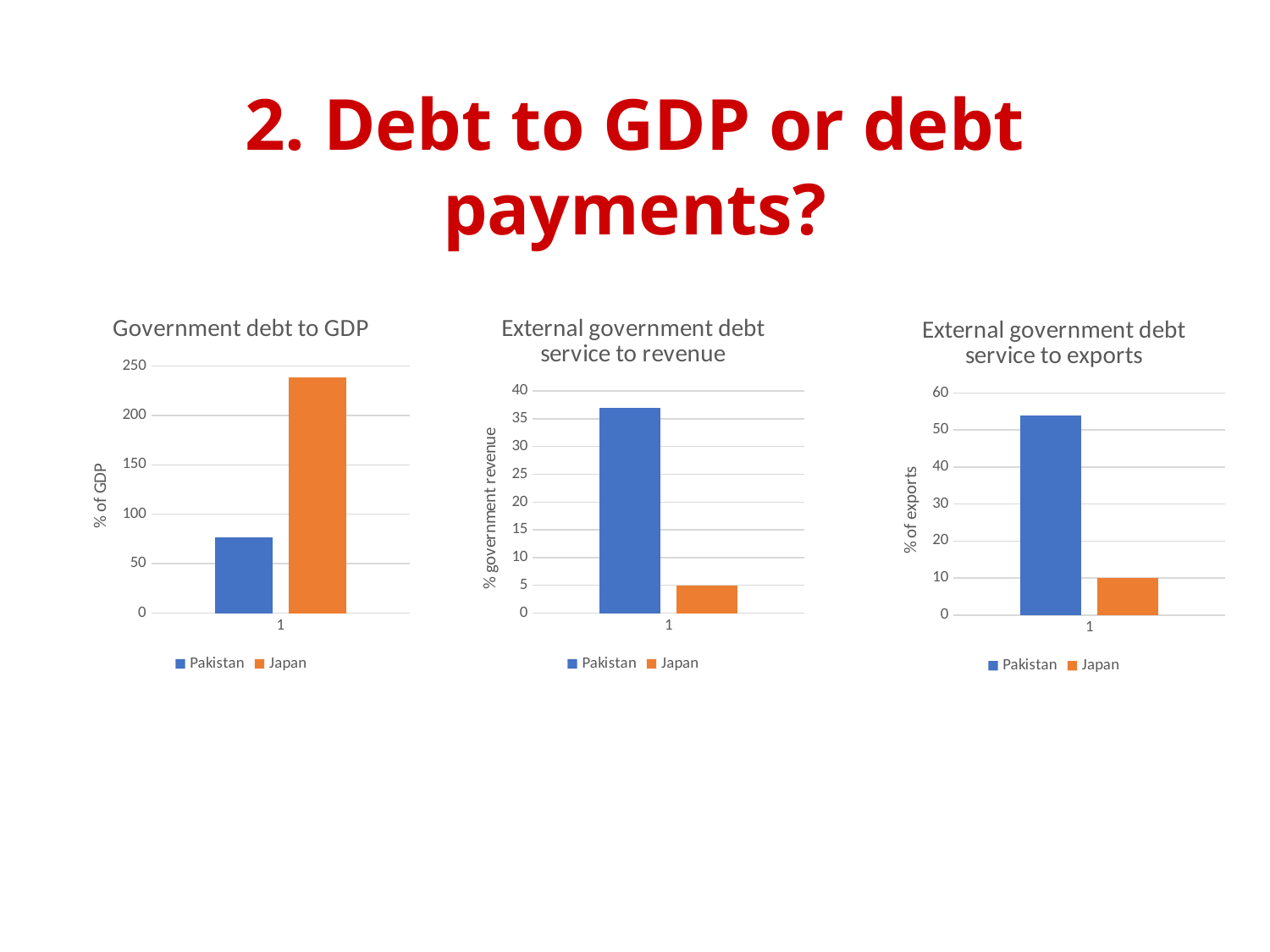
In the 'External government debt service to exports' chart, what is the label on the vertical axis? % of exports In the 'External government debt service to revenue' chart, is the value for Japan greater or less than 10? less In the 'External government debt service to revenue' chart, which country has the larger value, Pakistan or Japan? Pakistan In the 'Government debt to GDP' chart, what kind of chart is shown? bar chart In the 'External government debt service to exports' chart, is the value for Japan greater or less than 20? less In the 'External government debt service to exports' chart, is the value for Pakistan greater or less than 50? greater In the 'Government debt to GDP' chart, how many series does the legend list? 2 In the 'Government debt to GDP' chart, which country has the larger value, Pakistan or Japan? Japan In the 'External government debt service to revenue' chart, which series is shown in orange? Japan